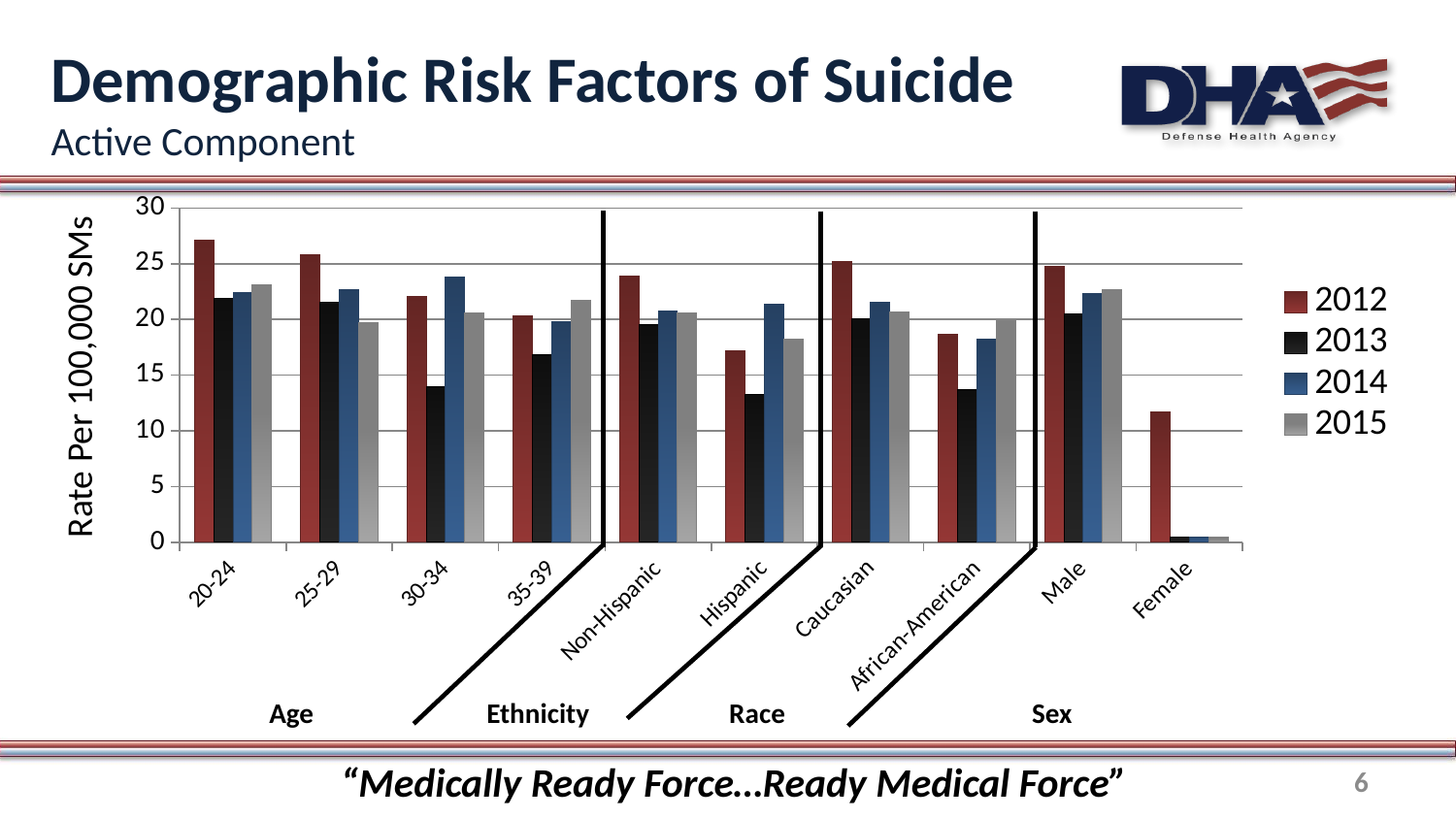
What is the label on the y axis of the chart? Rate Per 100,000 SMs Is the 2012 value for the 20-24 age group greater or less than 25? greater How many demographic categories are plotted along the x axis? 10 Which has the larger 2012 value, Male or Female? Male Which category has the highest 2012 value? 20-24 For the 30-34 age group, which year has the larger value, 2013 or 2014? 2014 How many series does the legend list? 4 Which category has the lowest 2012 value? Female Is the 2013 value for Hispanic greater or less than 15? less Is the 2012 value for Female greater or less than 15? less What kind of chart is shown on the slide? bar chart